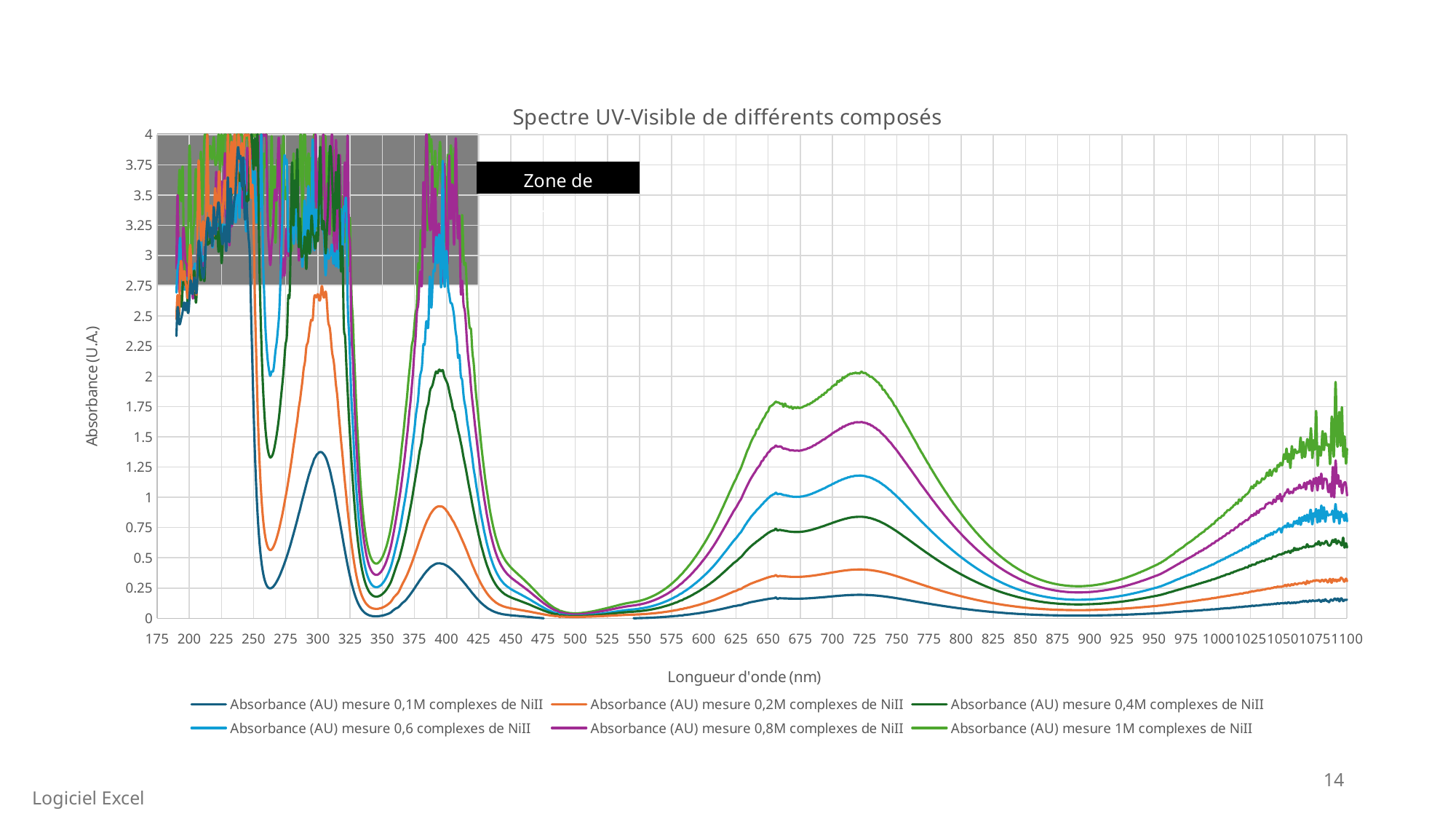
Which series has the lowest absorbance at 725 nm? Absorbance (AU) mesure 0,1M complexes de NiII Is the absorbance of the 0,4M complexes de NiII series at 400 nm greater or less than 1.5? greater At 300 nm, which series has the higher absorbance: 0,2M complexes de NiII or 0,1M complexes de NiII? 0,2M complexes de NiII How many series does the legend list? 6 What is the title of the chart? Spectre UV-Visible de différents composés Is the absorbance of the 0,1M complexes de NiII series at 725 nm greater or less than 0.25? less What is the label of the x axis? Longueur d'onde (nm) At 725 nm, which series has the higher absorbance: 0,8M complexes de NiII or 0,6 complexes de NiII? 0,8M complexes de NiII Which series has the highest absorbance at 725 nm? Absorbance (AU) mesure 1M complexes de NiII What kind of chart is shown on the slide? line chart Between 725 nm and 900 nm, does the absorbance of the 1M complexes de NiII series rise or fall? fall Is the absorbance of the 1M complexes de NiII series at 725 nm greater or less than 1.75? greater